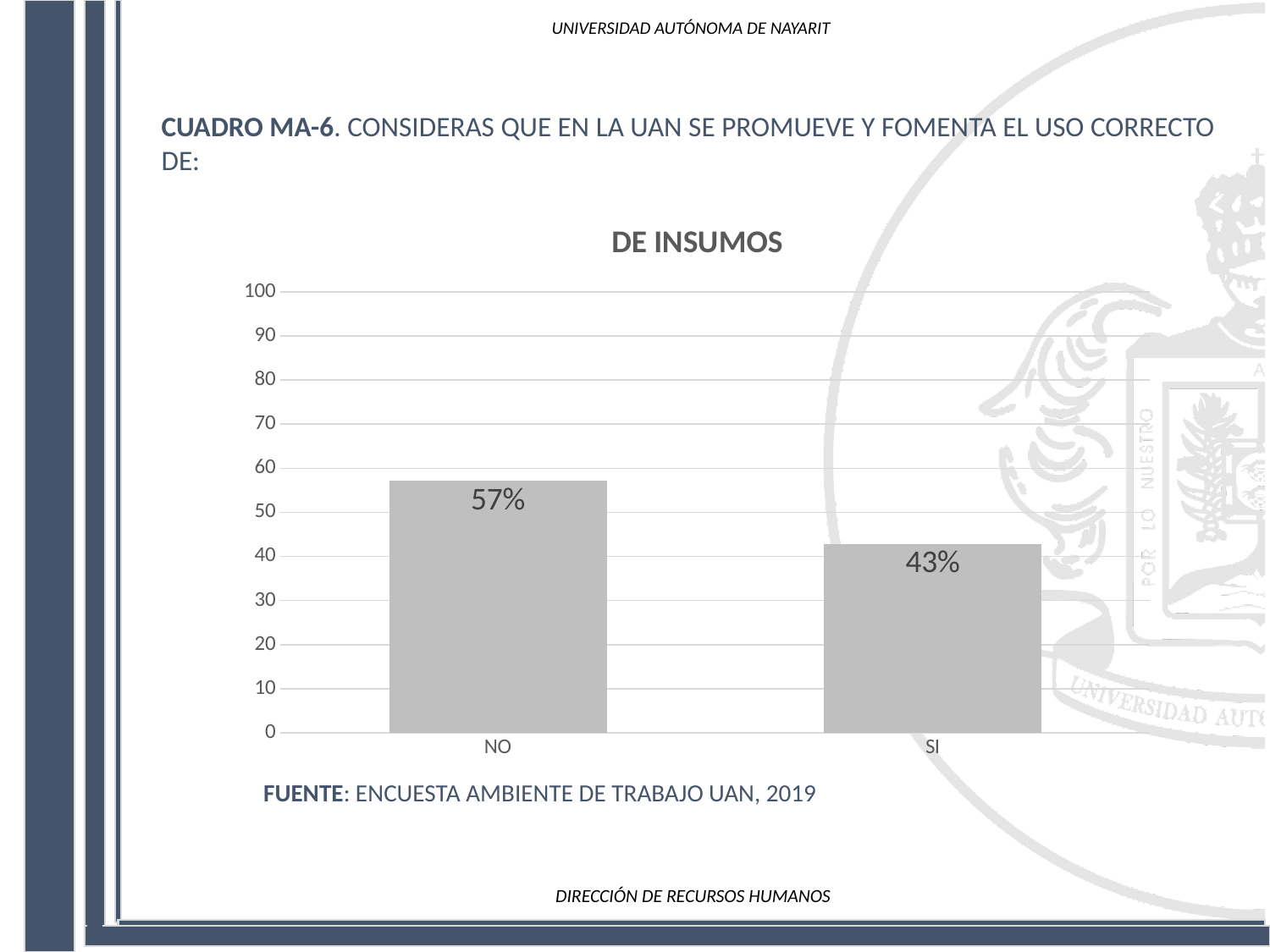
How many categories are shown on the x axis? 2 Which category has the highest value? NO Which category has the lowest value? SI Which is larger, the value for NO or the value for SI? NO Is the value for NO greater or less than 50? greater What is the title of the chart? DE INSUMOS What kind of chart is shown? bar chart What is the difference between the values for NO and SI? 14% What is the highest value shown on the y axis? 100 Is the value for SI greater or less than 50? less What is the value for SI? 43% What is the value for NO? 57%